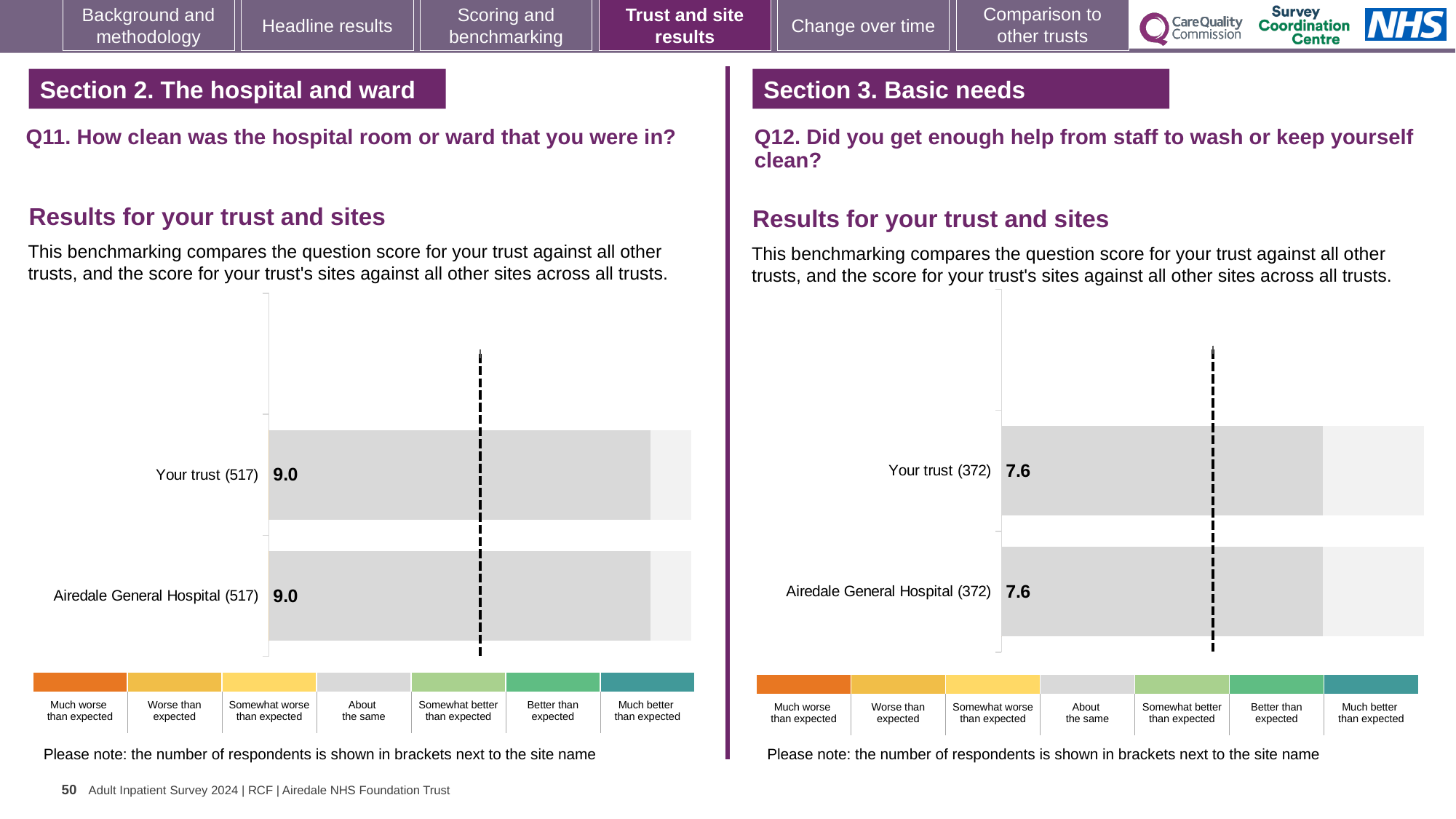
On the Q11 chart (left), what is the score for Airedale General Hospital? 9.0 On the Q11 chart (left), how many respondents are shown in brackets next to Your trust? 517 How many bars are plotted on the Q12 chart (right)? 2 Which is larger: the Airedale General Hospital score on the Q11 chart (left) or the Airedale General Hospital score on the Q12 chart (right)? Q11 chart (left) On the Q12 chart (right), what is the score for Your trust? 7.6 On the Q12 chart (right), how many respondents are shown in brackets next to Airedale General Hospital? 372 On the Q11 chart (left), what is the score for Your trust? 9.0 What is the difference between the Your trust score on the Q11 chart (left) and the Your trust score on the Q12 chart (right)? 1.4 What kind of chart is used on the Q11 chart (left)? Bar chart On the Q12 chart (right), what is the score for Airedale General Hospital? 7.6 How many bars are plotted on the Q11 chart (left)? 2